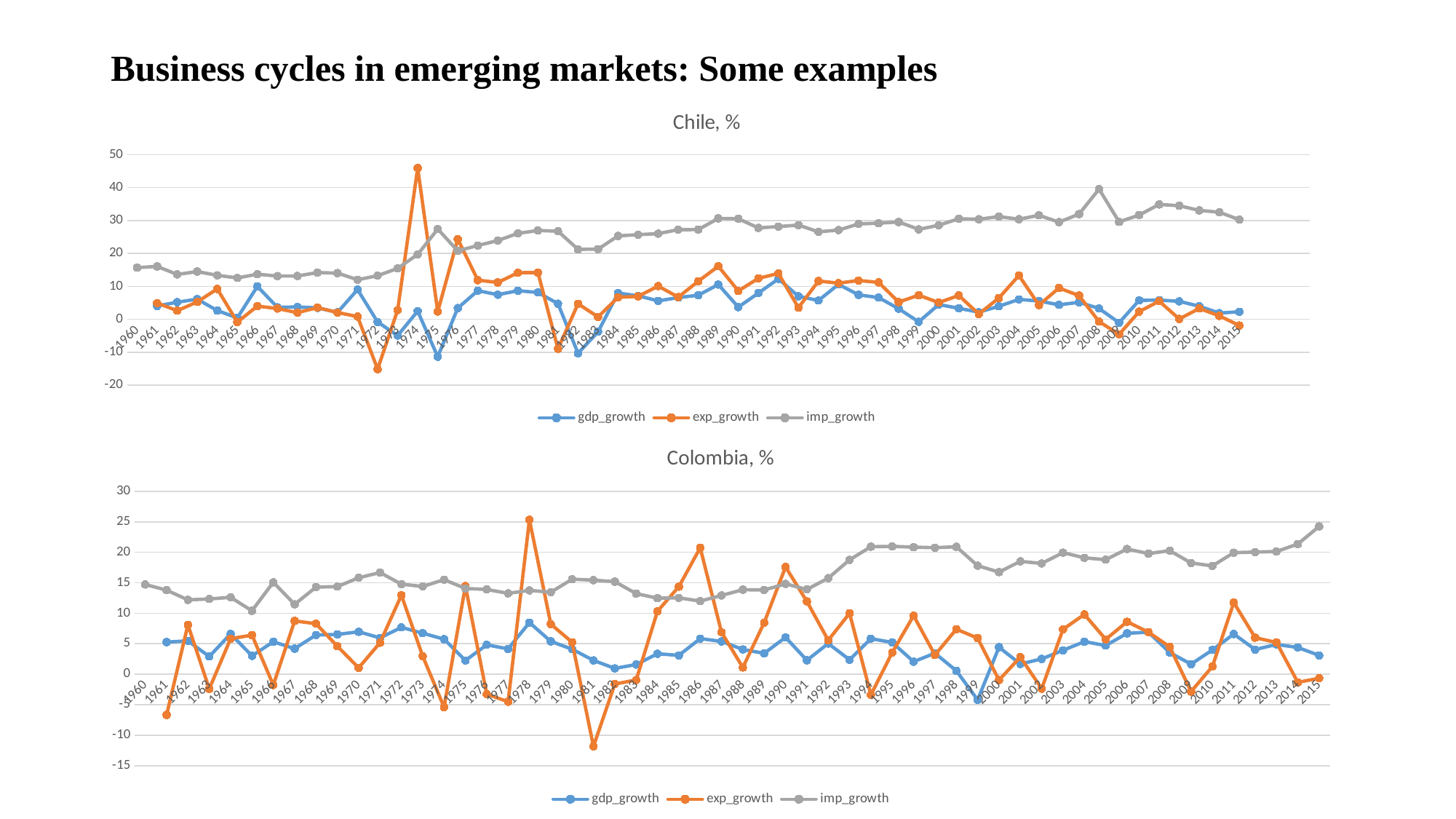
How many series does the legend of the Colombia, % chart list? 3 In the Chile, % chart, is the imp_growth value for 2008 greater or less than 30? greater In the Colombia, % chart, which year has the highest exp_growth value? 1978 In the Chile, % chart, which year has the highest exp_growth value? 1974 In the Colombia, % chart, is the imp_growth value for 2015 greater or less than 20? greater What is the title of the lower chart on the slide? Colombia, % In the Colombia, % chart, is the exp_growth value for 1981 greater or less than -10? less What kind of chart is the Chile, % chart? line chart In the Chile, % chart, which series has the highest value in 2015? imp_growth In the Colombia, % chart, which year has the lowest exp_growth value? 1981